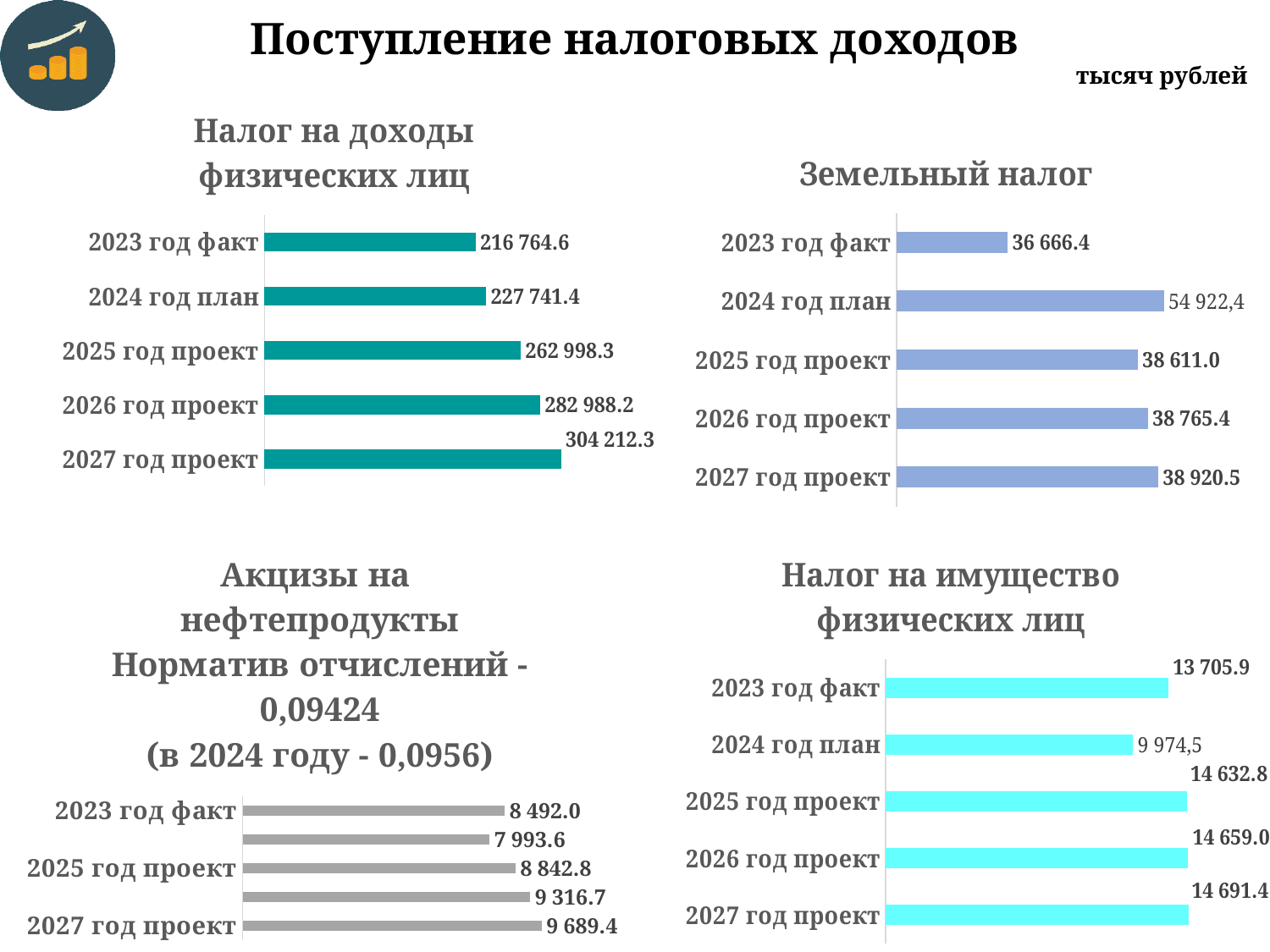
In the chart 'Налог на имущество физических лиц', which is larger: the value for 2025 год проект or 2024 год план? 2025 год проект How many categories are shown in the chart 'Налог на доходы физических лиц'? 5 In the chart 'Налог на имущество физических лиц', what is the value for 2023 год факт? 13 705.9 In the chart 'Земельный налог', what is the value for 2024 год план? 54 922,4 In the chart 'Налог на доходы физических лиц', what is the difference between the values for 2027 год проект and 2023 год факт? 87 447.7 In the chart 'Земельный налог', what is the difference between the values for 2024 год план and 2023 год факт? 18 256.0 In the chart 'Земельный налог', which category has the highest value? 2024 год план In the chart 'Налог на доходы физических лиц', what is the value for 2027 год проект? 304 212.3 In the chart 'Акцизы на нефтепродукты', what is the value for 2025 год проект? 8 842.8 In the chart 'Налог на имущество физических лиц', which category has the lowest value? 2024 год план In the chart 'Налог на доходы физических лиц', do the values rise or fall from 2023 год факт to 2027 год проект? Rise What kind of chart is 'Земельный налог'? Bar chart